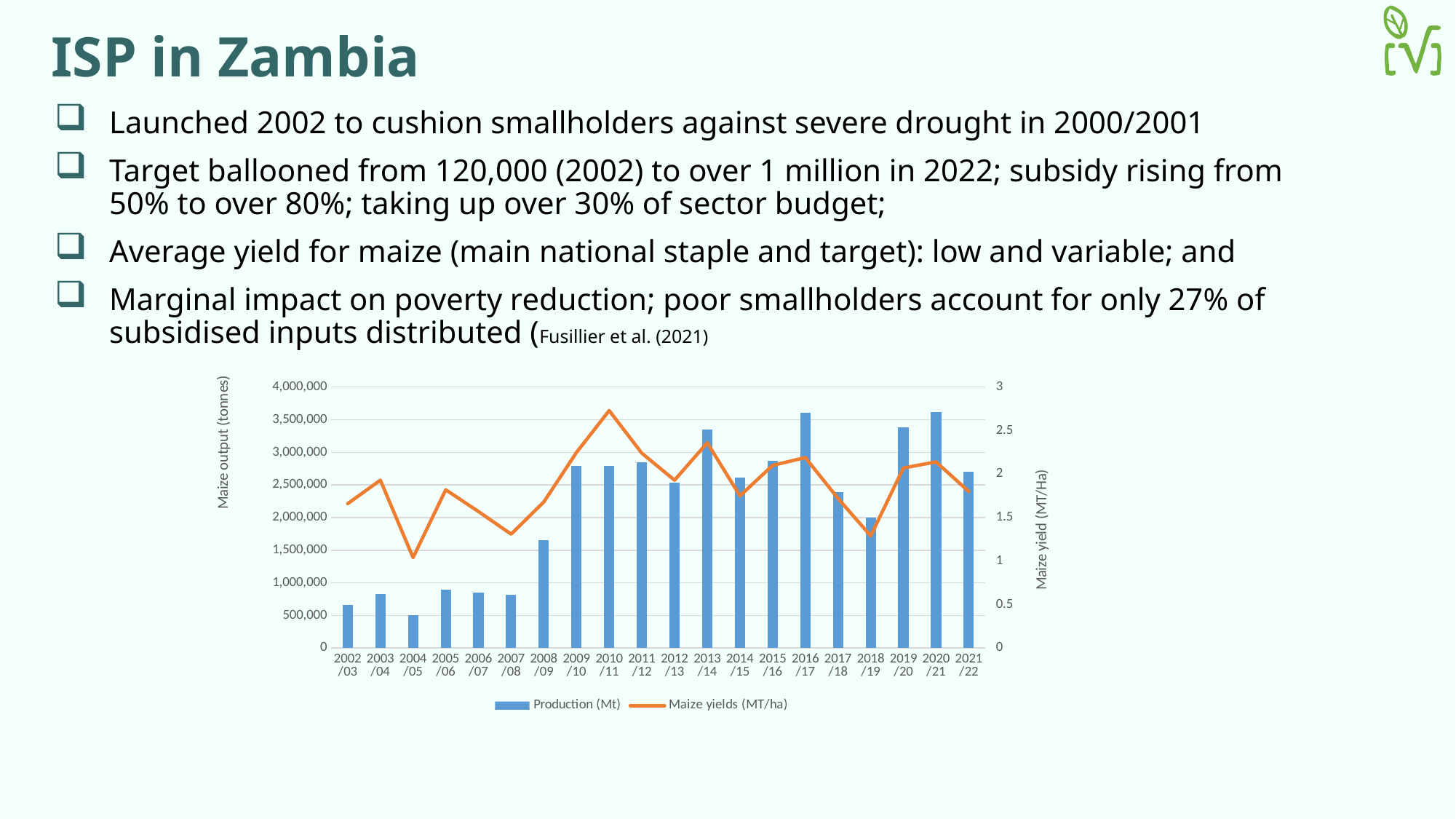
Which season has the larger Production (Mt) bar, 2008/09 or 2009/10? 2009/10 Is the Production (Mt) value for 2004/05 greater or less than 1,000,000? less Is the Maize yields (MT/ha) value for 2010/11 greater or less than 2.5? greater In which season is the Maize yields (MT/ha) line at its lowest point? 2004/05 In which season does the Maize yields (MT/ha) line reach its highest point? 2010/11 Is the Maize yields (MT/ha) value for 2018/19 greater or less than 1.5? less What kind of chart is shown on the slide? A combined bar and line chart Which season has the lowest Production (Mt) bar? 2004/05 How many seasons (categories) are shown on the x axis of the chart? 20 What is the title of the left vertical axis of the chart? Maize output (tonnes) How many series does the chart legend list? 2